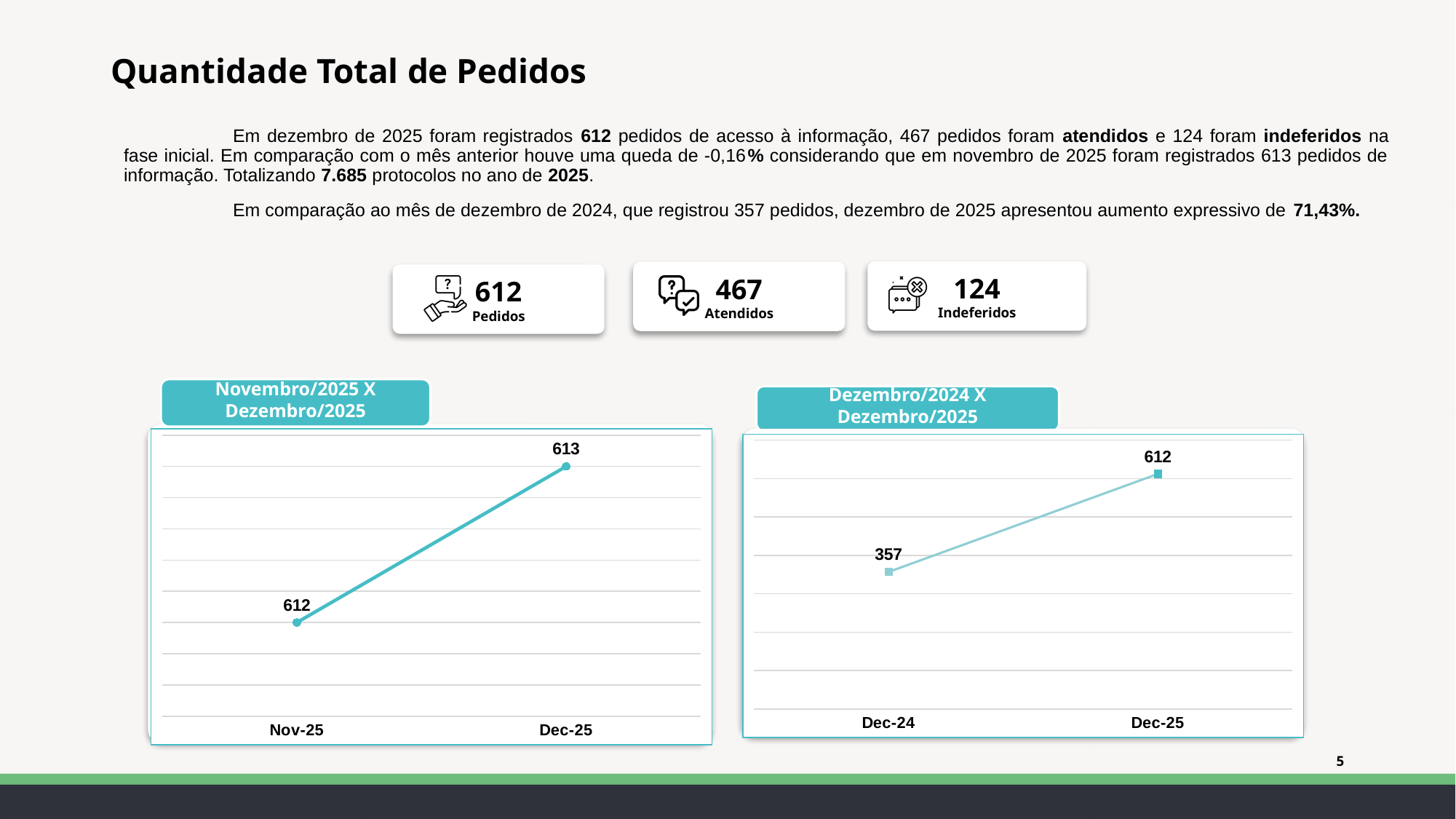
In the chart titled 'Novembro/2025 X Dezembro/2025', what is the difference between the Dec-25 and Nov-25 values? 1 In the chart titled 'Dezembro/2024 X Dezembro/2025', what is the value for Dec-24? 357 How many data points are plotted in the chart titled 'Novembro/2025 X Dezembro/2025'? 2 In the chart titled 'Dezembro/2024 X Dezembro/2025', what is the difference between the Dec-25 and Dec-24 values? 255 In the chart titled 'Dezembro/2024 X Dezembro/2025', is the value for Dec-24 larger or smaller than the value for Dec-25? smaller In the chart titled 'Dezembro/2024 X Dezembro/2025', which point has the lowest value? Dec-24 In the chart titled 'Dezembro/2024 X Dezembro/2025', do the values rise or fall from Dec-24 to Dec-25? rise In the chart titled 'Novembro/2025 X Dezembro/2025', what is the value for Nov-25? 612 In the chart titled 'Dezembro/2024 X Dezembro/2025', which point has the highest value? Dec-25 In the chart titled 'Dezembro/2024 X Dezembro/2025', what is the value for Dec-25? 612 In the chart titled 'Novembro/2025 X Dezembro/2025', what is the value for Dec-25? 613 What kind of chart is the chart titled 'Dezembro/2024 X Dezembro/2025'? line chart